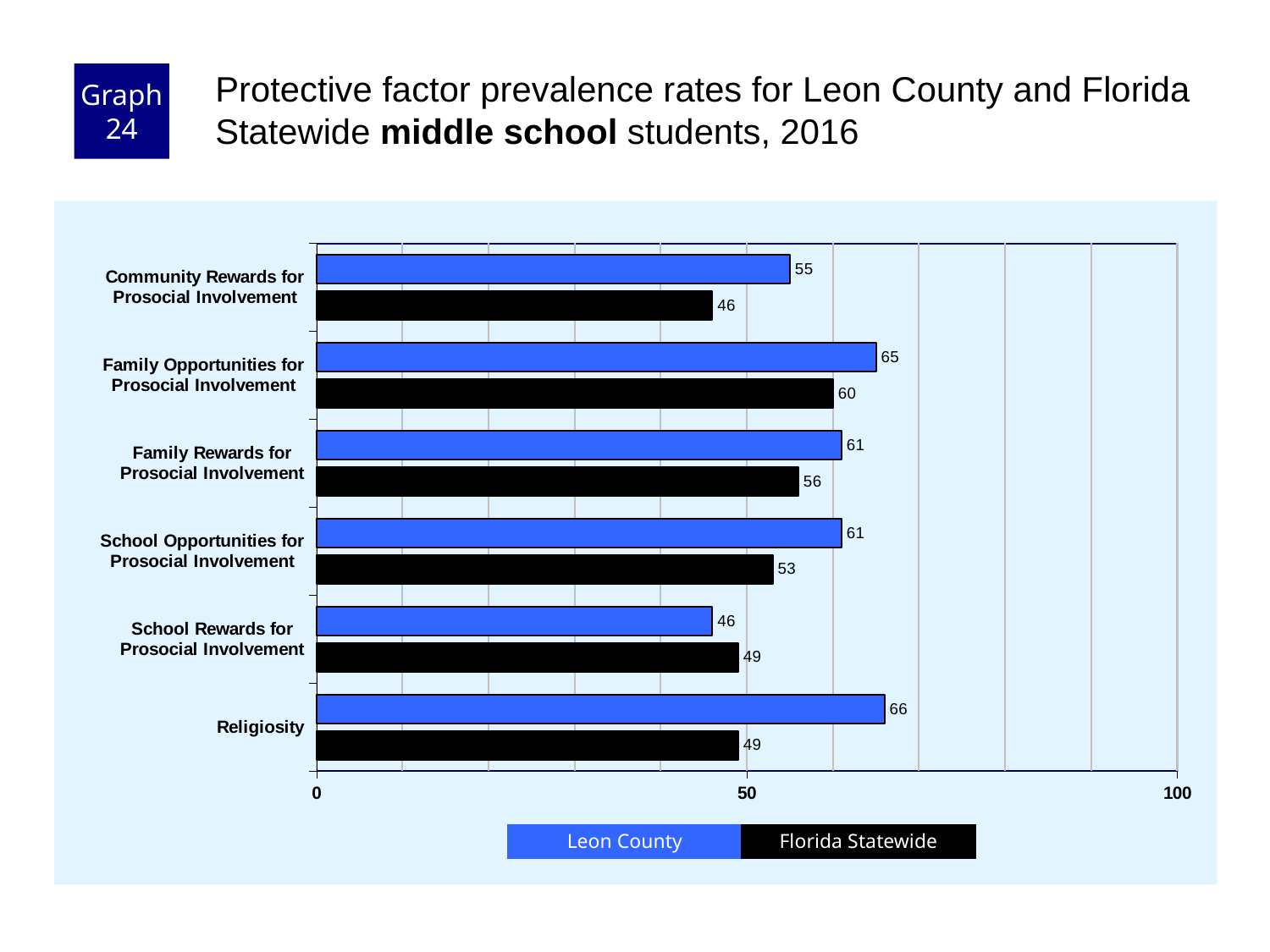
What is the difference between the Leon County and Florida Statewide values for Religiosity? 17 Is the Florida Statewide value for Family Opportunities for Prosocial Involvement greater or less than 50? greater What is the Leon County value for Family Opportunities for Prosocial Involvement? 65 Which category has the highest Leon County value? Religiosity Which colour represents Florida Statewide in the chart? Black Which category has the lowest Florida Statewide value? Community Rewards for Prosocial Involvement What kind of chart is shown on the slide? Bar chart How many protective factor categories are shown on the chart? 6 What is the Florida Statewide value for Community Rewards for Prosocial Involvement? 46 How many series does the legend list? 2 For School Rewards for Prosocial Involvement, which is larger: the Leon County value or the Florida Statewide value? Florida Statewide What is the Leon County value for Religiosity? 66